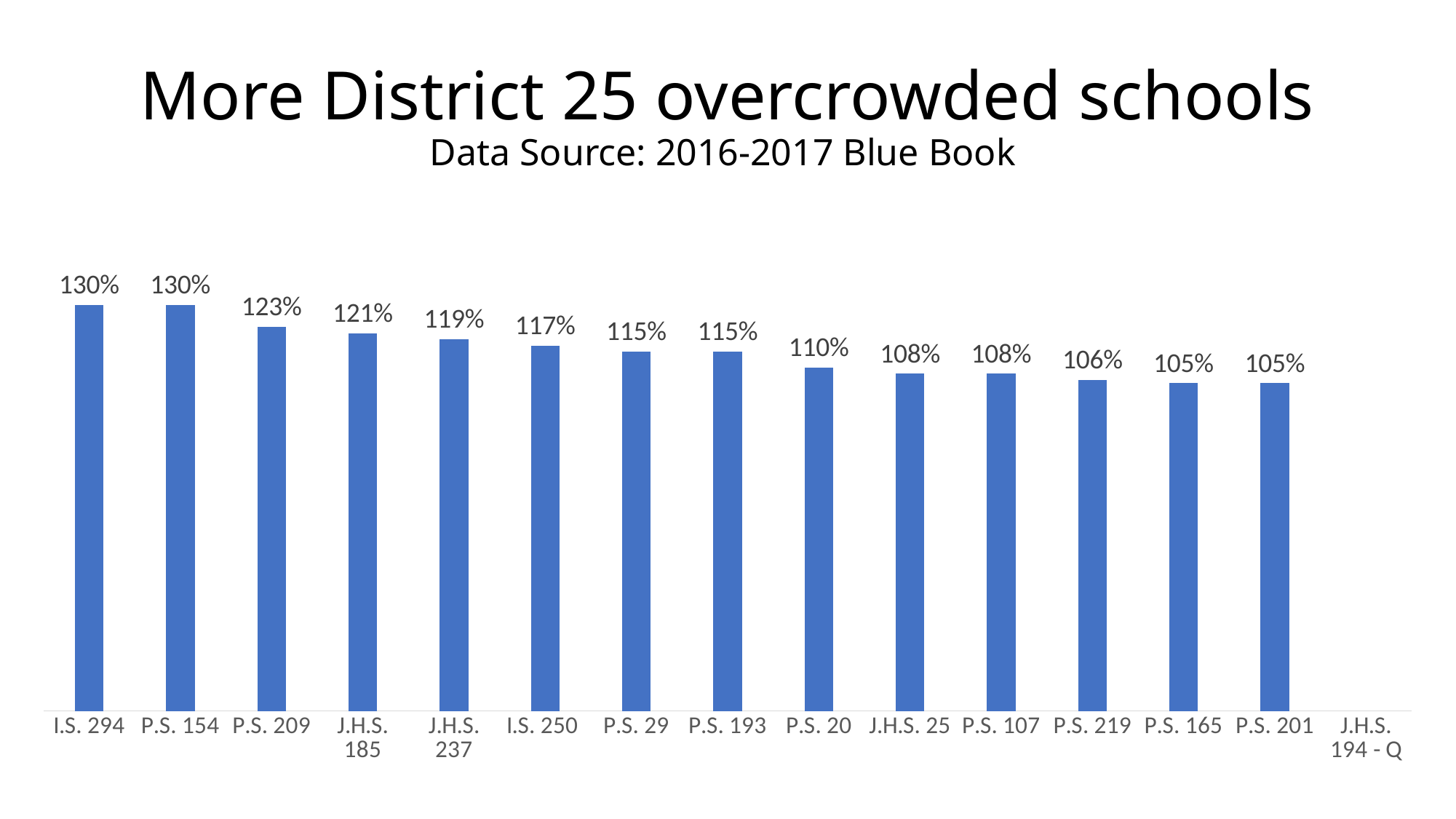
What is the difference between the values for I.S. 294 and P.S. 201? 25 percentage points What is the value shown for P.S. 209? 123% What is the title of the chart on the slide? More District 25 overcrowded schools What is the value shown for I.S. 294? 130% What is the value shown for P.S. 201? 105% What is the value shown for P.S. 219? 106% What is the difference between the values for P.S. 209 and P.S. 20? 13 percentage points What is the value shown for J.H.S. 237? 119% Which has a higher value, J.H.S. 185 or I.S. 250? J.H.S. 185 What kind of chart is shown on the slide? bar chart What is the value shown for P.S. 20? 110% Do the values rise or fall moving from left to right along the x axis? fall